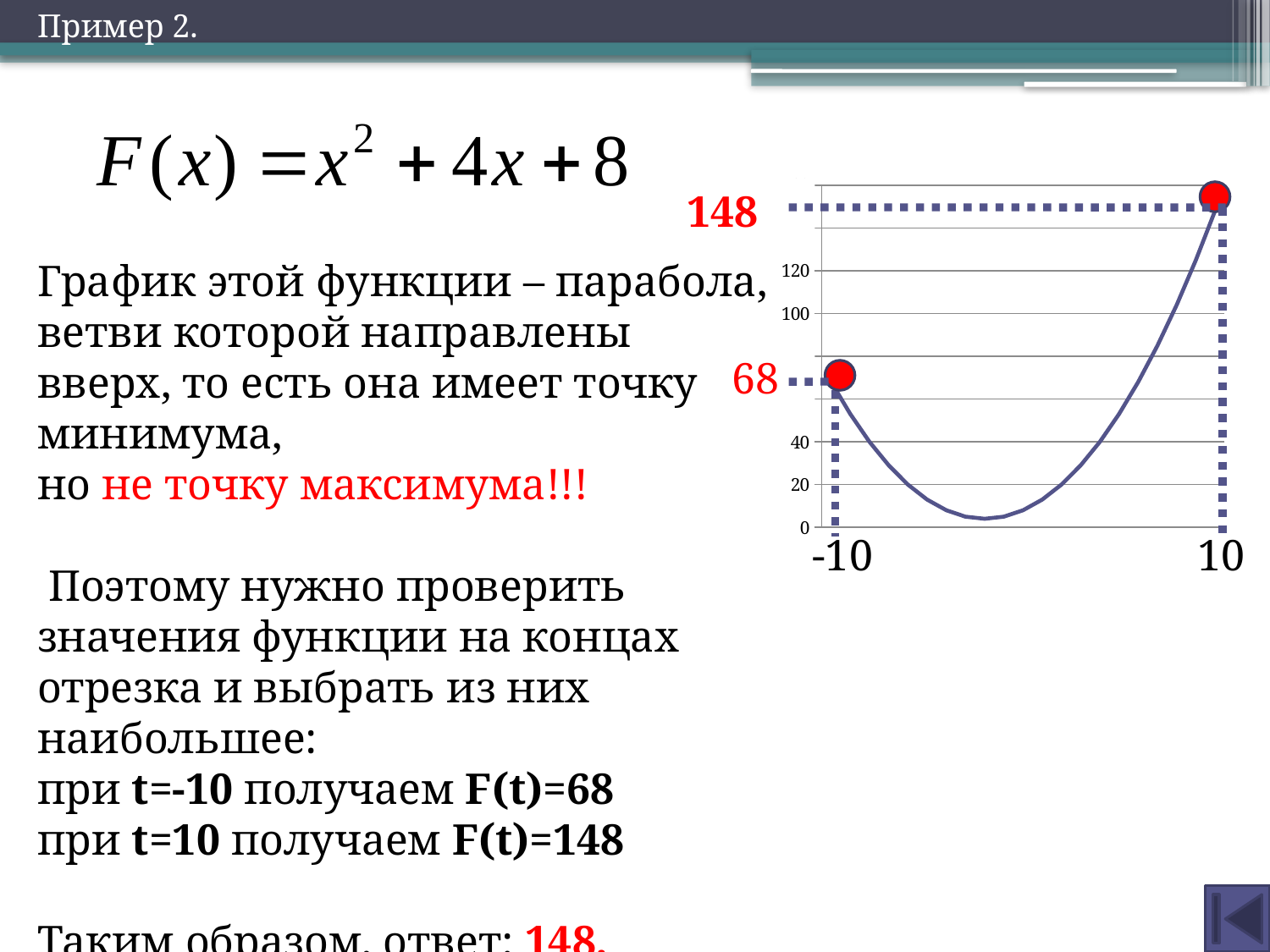
What is the difference between the function values at x = 10 and x = -10? 80 What is the value of the function at x = 10 on the chart? 148 At which x value shown on the chart does the function reach its highest value? 10 Which endpoint of the chart has the larger function value, x = -10 or x = 10? x = 10 What is the value of the function at x = -10 on the chart? 68 Is the lowest point of the curve on the chart greater or less than 20? less How does the curve behave as x goes from -10 to 10? falls, then rises What kind of chart is shown on the slide? line chart How many red marked points are shown on the curve? 2 What are the two x values labeled on the horizontal axis of the chart? -10 and 10 What is the lowest value labeled on the vertical axis of the chart? 0 Is the value of the function at x = -10 greater or less than 40? greater